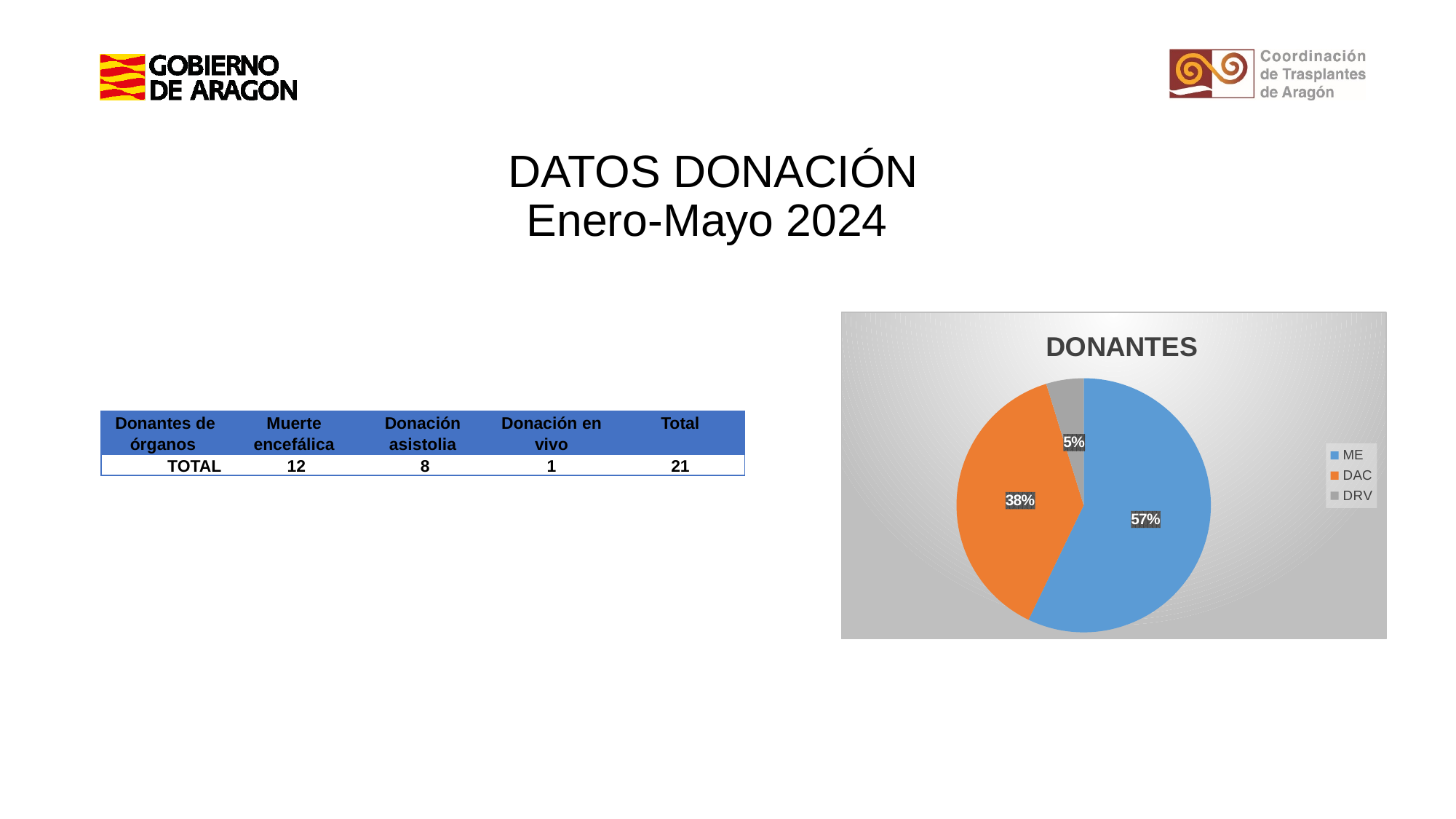
Which category has the smallest slice in the DONANTES pie chart? DRV What is the difference in percentage points between the ME and DAC slices in the DONANTES chart? 19% What share of the DONANTES pie does ME represent? 57% Which category has the largest slice in the DONANTES pie chart? ME In the DONANTES pie chart, which slice is larger, DAC or DRV? DAC What is the title of the chart on the slide? DONANTES What colour is the ME slice in the DONANTES pie chart? blue How many entries does the legend of the DONANTES chart list? 3 What share of the DONANTES pie does DRV represent? 5% How many slices does the DONANTES pie chart have? 3 What kind of chart is the DONANTES chart? pie chart What share of the DONANTES pie does DAC represent? 38%